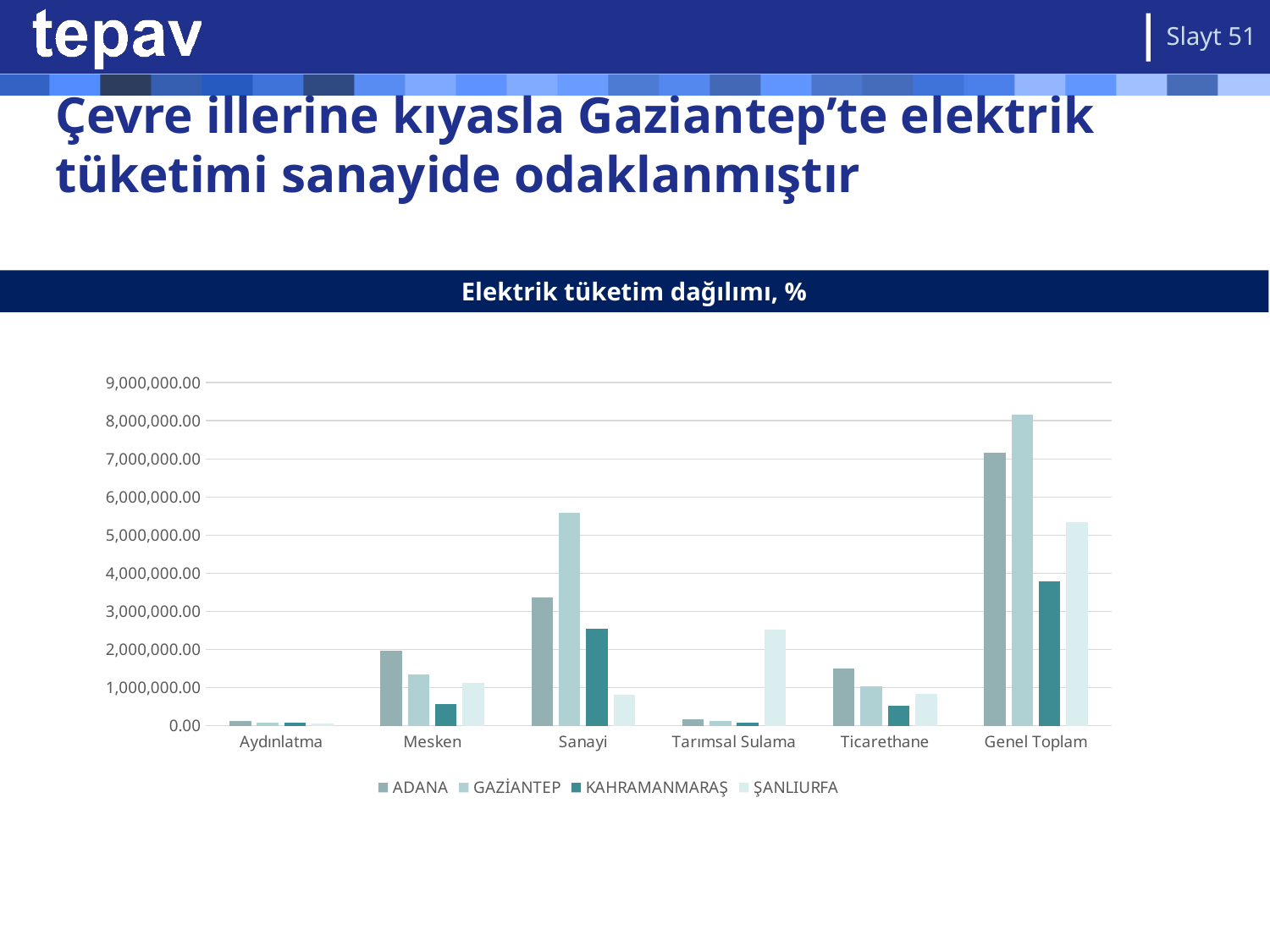
In the Mesken category, which is larger: ADANA or GAZİANTEP? ADANA Is the value for GAZİANTEP in Sanayi greater or less than 5,000,000.00? greater In the Ticarethane category, which is larger: ŞANLIURFA or KAHRAMANMARAŞ? ŞANLIURFA Which series has the highest value in the Genel Toplam category? GAZİANTEP Is the value for KAHRAMANMARAŞ in Genel Toplam greater or less than 3,000,000.00? greater What is the title of the chart? Elektrik tüketim dağılımı, % Which series has the highest value in the Sanayi category? GAZİANTEP How many series does the legend list? 4 How many categories are shown on the x axis? 6 Which series has the highest value in the Tarımsal Sulama category? ŞANLIURFA Which series has the lowest value in the Genel Toplam category? KAHRAMANMARAŞ What kind of chart is shown on the slide? bar chart